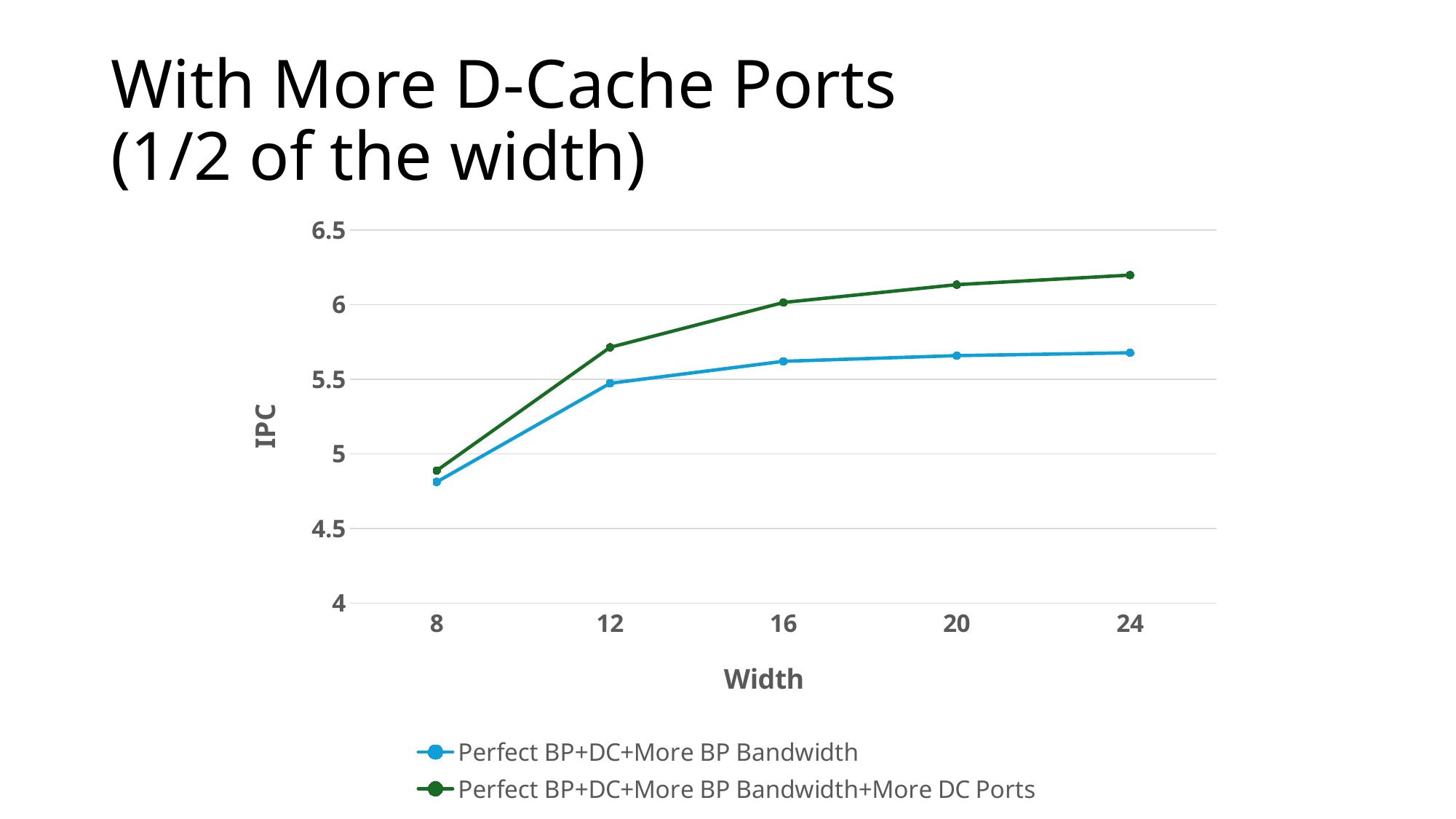
Is the IPC value for Perfect BP+DC+More BP Bandwidth+More DC Ports at width 24 greater or less than 6? greater How many width values are plotted along the x axis? 5 Do the IPC values rise or fall as width increases from 8 to 24? rise Is the IPC value for Perfect BP+DC+More BP Bandwidth+More DC Ports at width 20 greater or less than 6? greater Is the IPC value for Perfect BP+DC+More BP Bandwidth at width 24 greater or less than 6? less At width 24, which series has the higher IPC? Perfect BP+DC+More BP Bandwidth+More DC Ports At which width does the Perfect BP+DC+More BP Bandwidth+More DC Ports series reach its highest IPC? 24 What kind of chart is shown on the slide? line chart At which width does the Perfect BP+DC+More BP Bandwidth series have its lowest IPC? 8 How many series does the legend list? 2